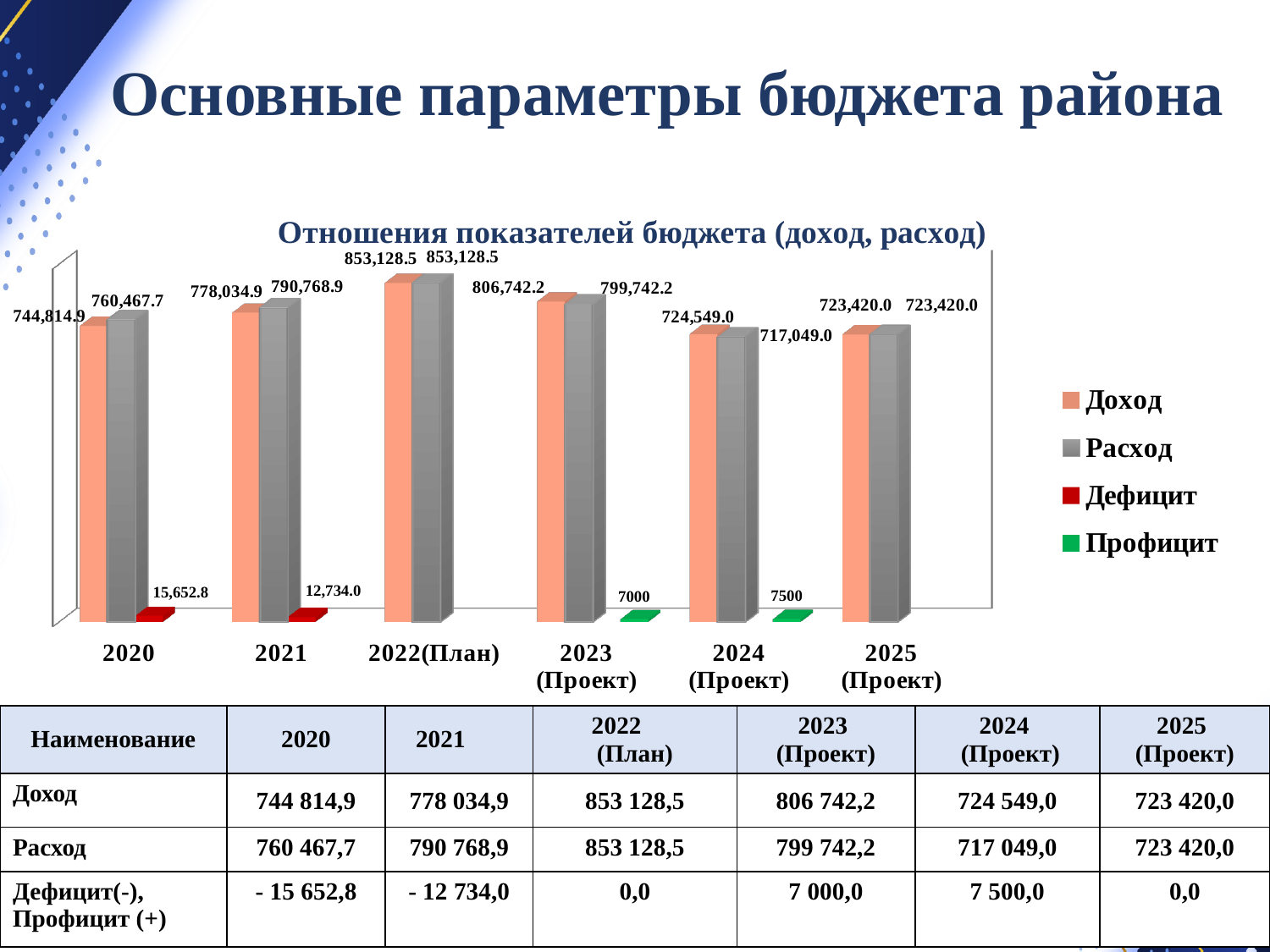
What is the Профицит value shown for 2024 (Проект)? 7500 In which year is Доход the highest? 2022(План) In 2023 (Проект), which is larger: Доход or Расход? Доход What is the difference between Расход and Доход in 2021? 12,734.0 How many series does the chart legend list? 4 What is the value of Расход for 2021 in the chart? 790,768.9 Does Доход rise or fall from 2022(План) to 2025 (Проект)? Fall In which year is Расход the lowest? 2024 (Проект) How many years (categories) are shown on the x axis of the chart? 6 What is the Дефицит value shown for 2020? 15,652.8 What type of chart is shown on the slide? Bar chart What is the value of Доход for 2020 in the chart? 744,814.9